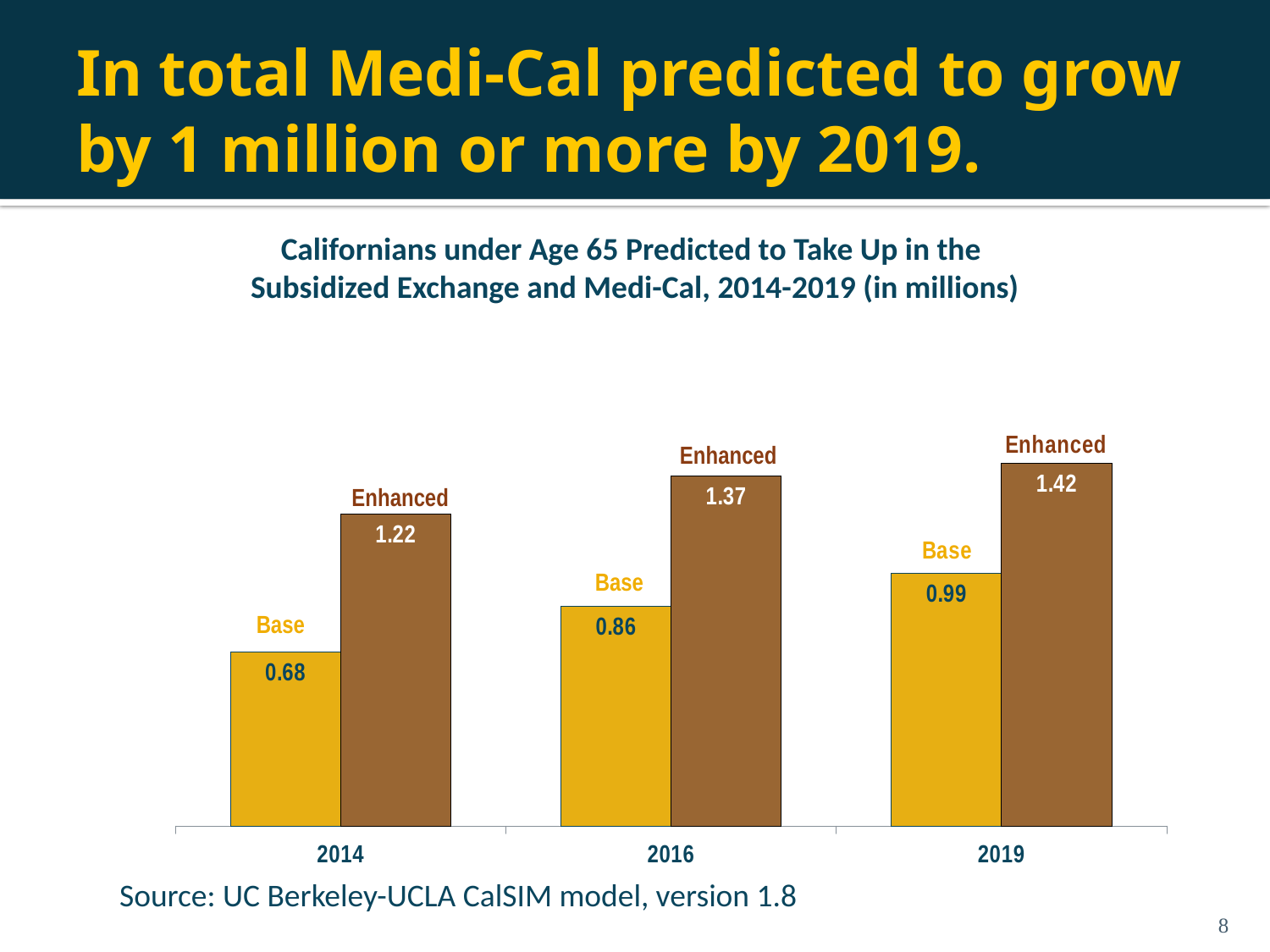
Which is larger, the Enhanced value for 2014 or the Base value for 2019? Enhanced value for 2014 What is the Enhanced value for 2016? 1.37 What is the difference between the Base values for 2019 and 2016? 0.13 What is the Base value for 2019? 0.99 Which year has the lowest Base value? 2014 Do the Base values rise or fall from 2014 to 2019? Rise What is the Enhanced value for 2019? 1.42 What is the difference between the Enhanced and Base values in 2014? 0.54 Which year has the highest Enhanced value? 2019 How many years are shown on the x axis? 3 What is the Base value for 2014? 0.68 What kind of chart is shown on the slide? Bar chart